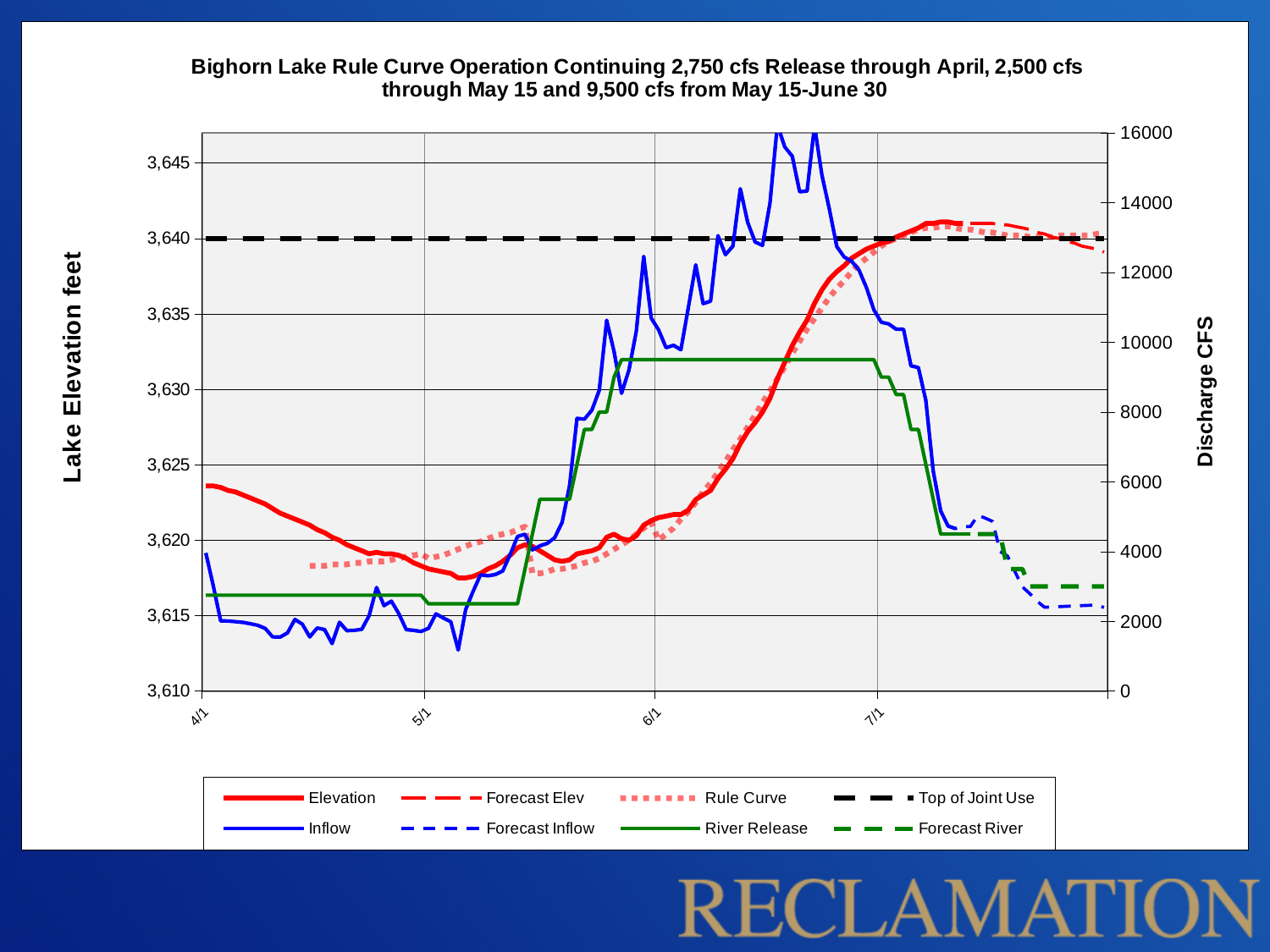
Does the Elevation line rise or fall between 6/1 and 7/1? rise Is the River Release plateau between 6/1 and 7/1 greater or less than 10000 cfs? less Which series reaches the highest value on the Discharge CFS axis? Inflow At what lake elevation does the Top of Joint Use line sit? 3,640 Is the Forecast River value at the right end of the chart greater or less than 4000 cfs? less How many series does the legend list? 8 What is the label of the right-hand vertical axis? Discharge CFS Is the Elevation value at 5/1 greater or less than 3,625? less Which is higher at 6/1, the Elevation line or the Top of Joint Use line? Top of Joint Use What kind of chart is shown on the slide? line chart